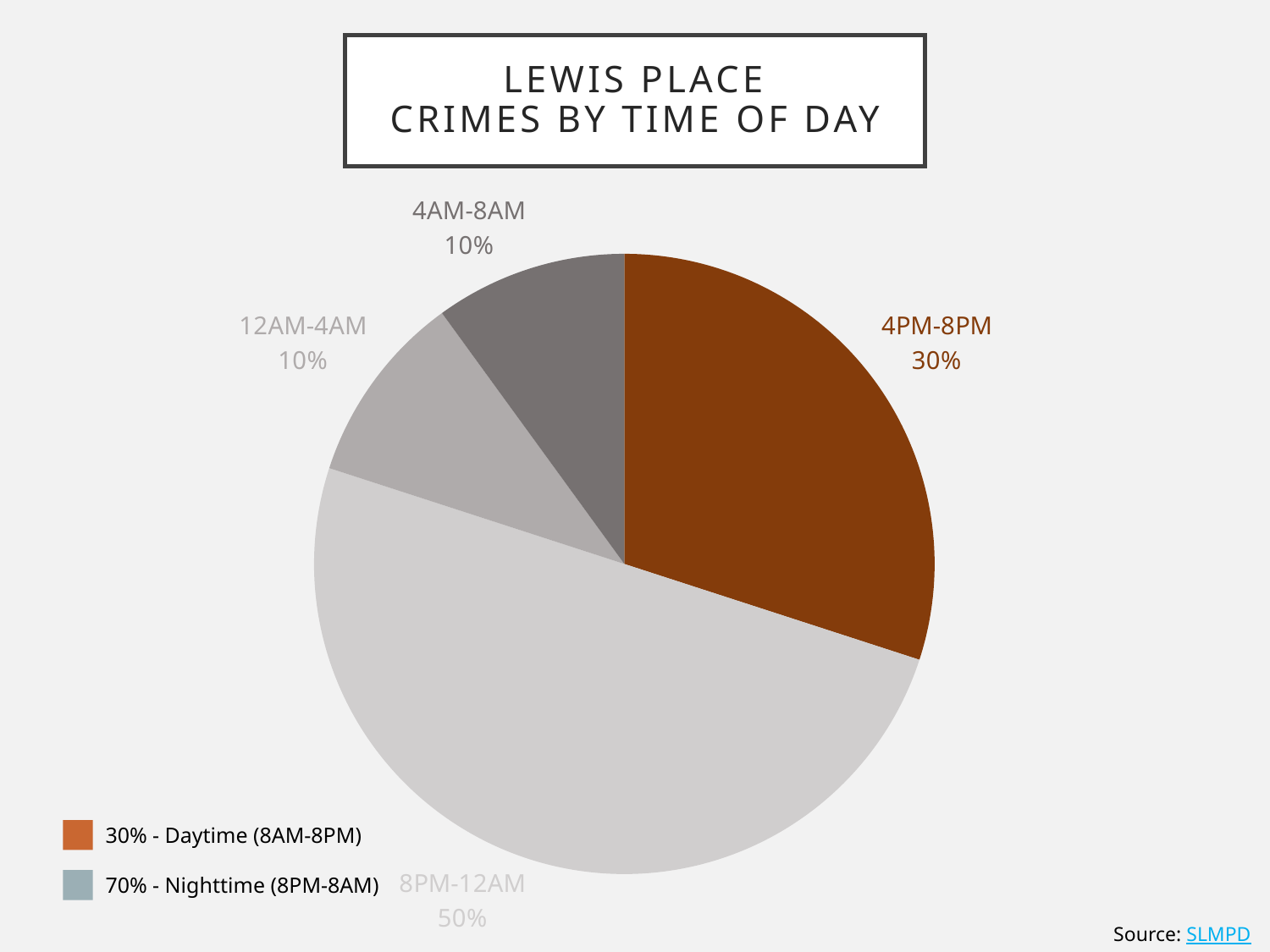
How many time-of-day slices does the pie chart show? 4 What is the combined share of the 12AM-4AM and 4AM-8AM slices? 20% What is the title of the chart? Lewis Place Crimes by Time of Day What share of crimes occurred between 12AM and 4AM? 10% What share of crimes occurred between 8PM and 12AM? 50% What kind of chart is shown on the slide? Pie chart What share of crimes occurred between 4AM and 8AM? 10% Which slice is larger, 4PM-8PM or 12AM-4AM? 4PM-8PM According to the legend, what percentage of crimes occurred during Nighttime (8PM-8AM)? 70% What is the difference in percentage points between the 8PM-12AM slice and the 4PM-8PM slice? 20% Which time period has the largest share of crimes? 8PM-12AM What share of crimes occurred between 4PM and 8PM? 30%